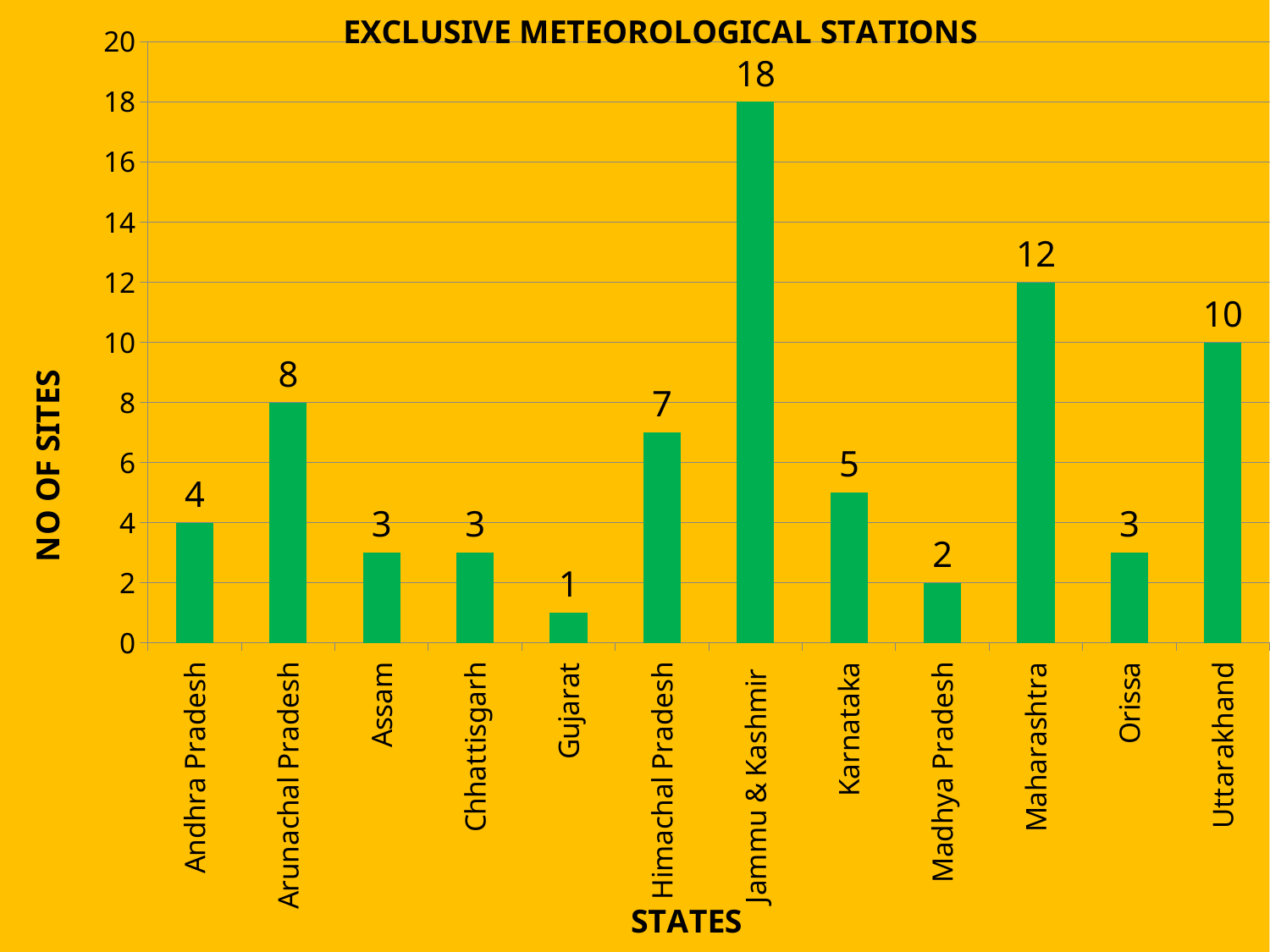
Which state has the highest number of sites? Jammu & Kashmir What is the label of the y axis? NO OF SITES What is the title of the chart? EXCLUSIVE METEOROLOGICAL STATIONS What is the difference in number of sites between Jammu & Kashmir and Maharashtra? 6 How many states are shown on the x axis? 12 What kind of chart is shown on the slide? Bar chart Is the value for Uttarakhand greater or less than 8? greater What is the number of sites for Gujarat? 1 What is the number of sites for Jammu & Kashmir? 18 Which state has the lowest number of sites? Gujarat Which has more sites, Arunachal Pradesh or Himachal Pradesh? Arunachal Pradesh What is the number of sites for Maharashtra? 12